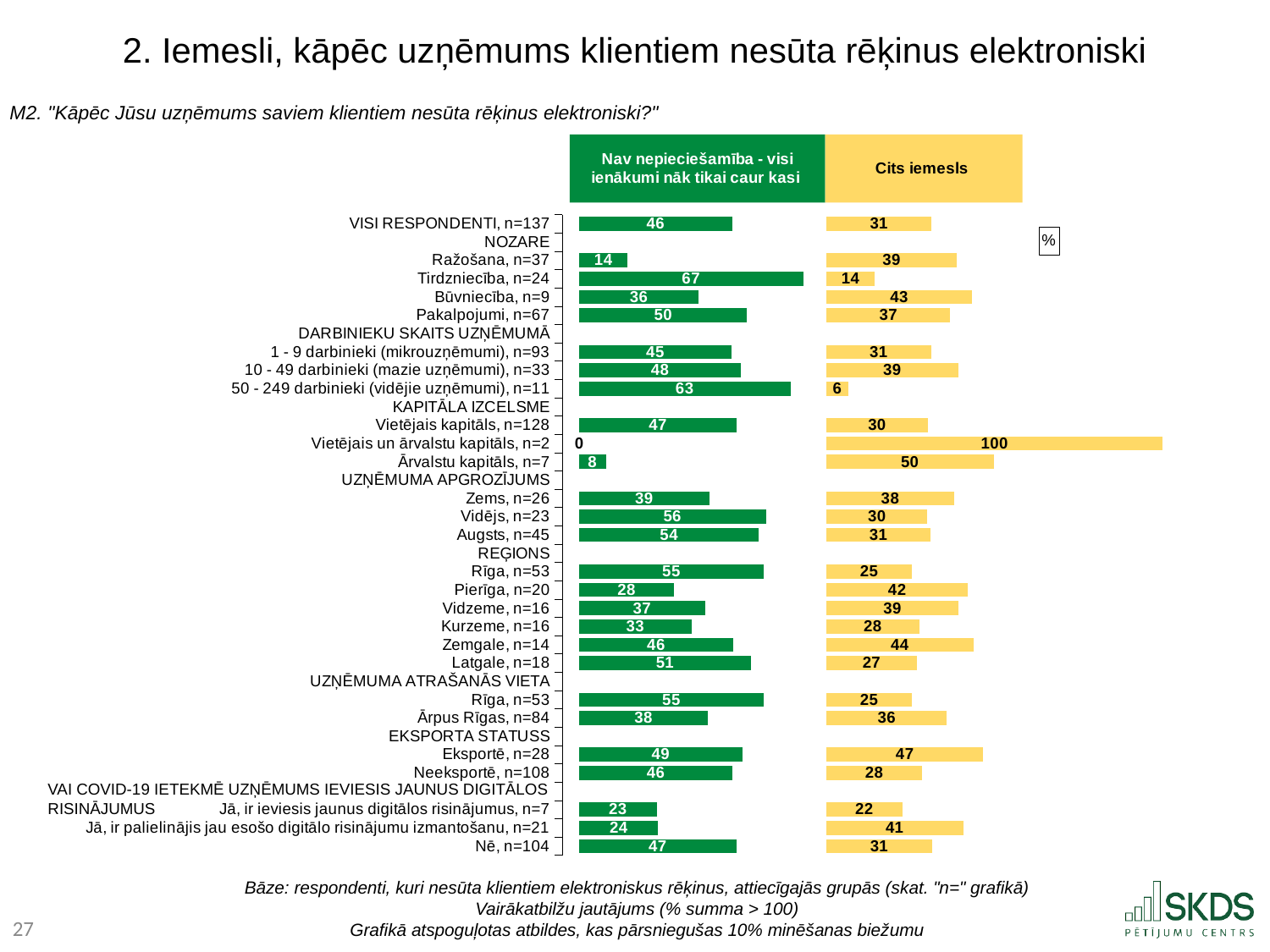
What is the value of "Nav nepieciešamība - visi ienākumi nāk tikai caur kasi" for Tirdzniecība, n=24? 67 How many series does the chart show? 2 For Ražošana, n=37, which series has the larger value: "Nav nepieciešamība - visi ienākumi nāk tikai caur kasi" or "Cits iemesls"? Cits iemesls Which category has the lowest value for "Nav nepieciešamība - visi ienākumi nāk tikai caur kasi"? Vietējais un ārvalstu kapitāls, n=2 Which category has the lowest value for "Cits iemesls"? 50 - 249 darbinieki (vidējie uzņēmumi), n=11 Which category has the highest value for "Nav nepieciešamība - visi ienākumi nāk tikai caur kasi"? Tirdzniecība, n=24 What is the value of "Cits iemesls" for VISI RESPONDENTI, n=137? 31 What is the difference between the "Nav nepieciešamība - visi ienākumi nāk tikai caur kasi" and "Cits iemesls" values for Rīga, n=53 (under REĢIONS)? 30 What is the value of "Cits iemesls" for Vietējais un ārvalstu kapitāls, n=2? 100 What kind of chart is shown on the slide? Bar chart What is the value of "Nav nepieciešamība - visi ienākumi nāk tikai caur kasi" for VISI RESPONDENTI, n=137? 46 What colour are the bars for the "Cits iemesls" series? Yellow